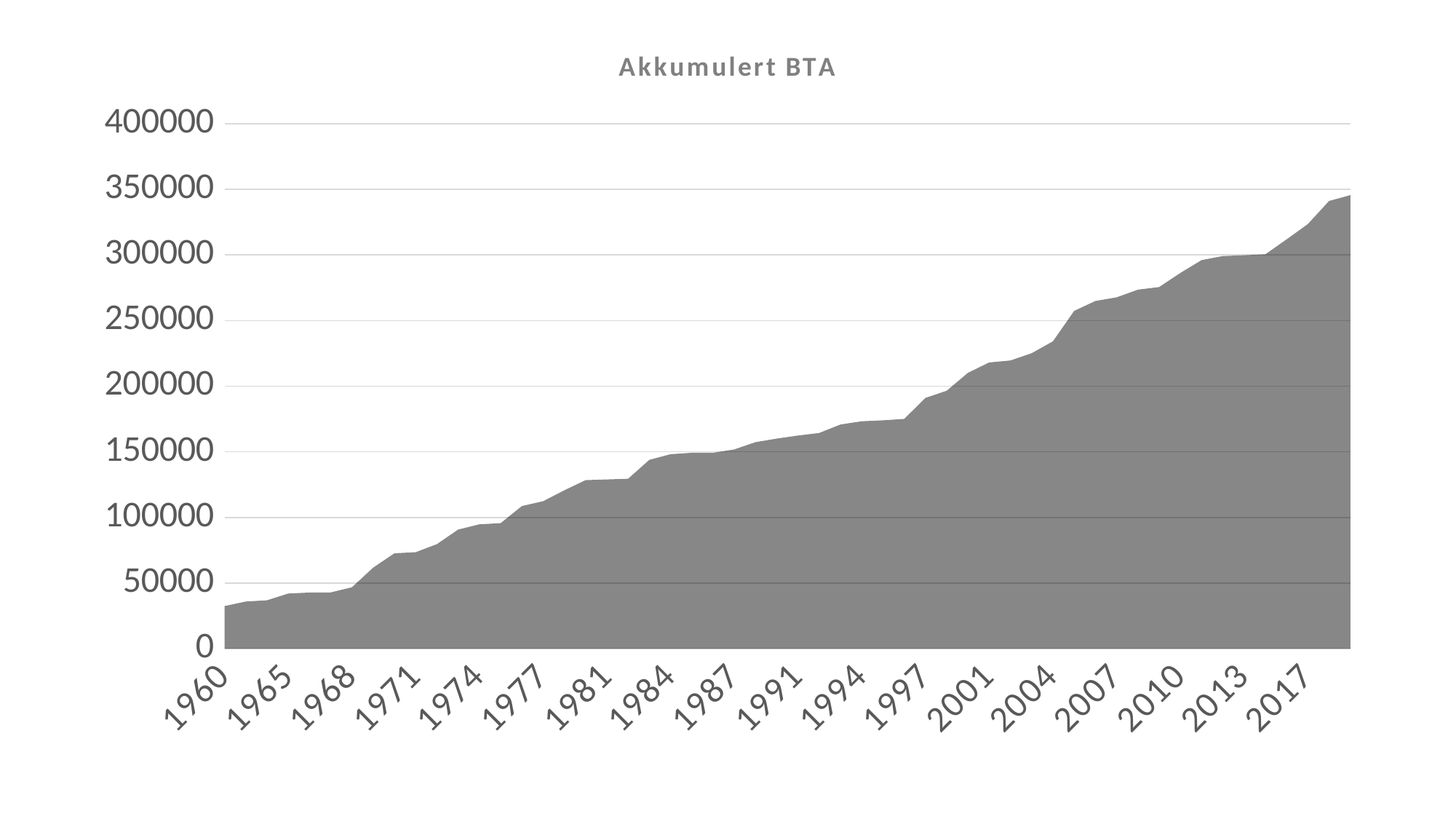
What kind of chart is shown on the slide? Area chart Is the value for 2001 greater or less than 200000? greater Is the value for 1997 greater or less than 150000? greater Is the value for 1974 greater or less than 100000? less Do the values rise or fall along the x axis from 1960 to the end of the series? Rise What is the title of the chart? Akkumulert BTA